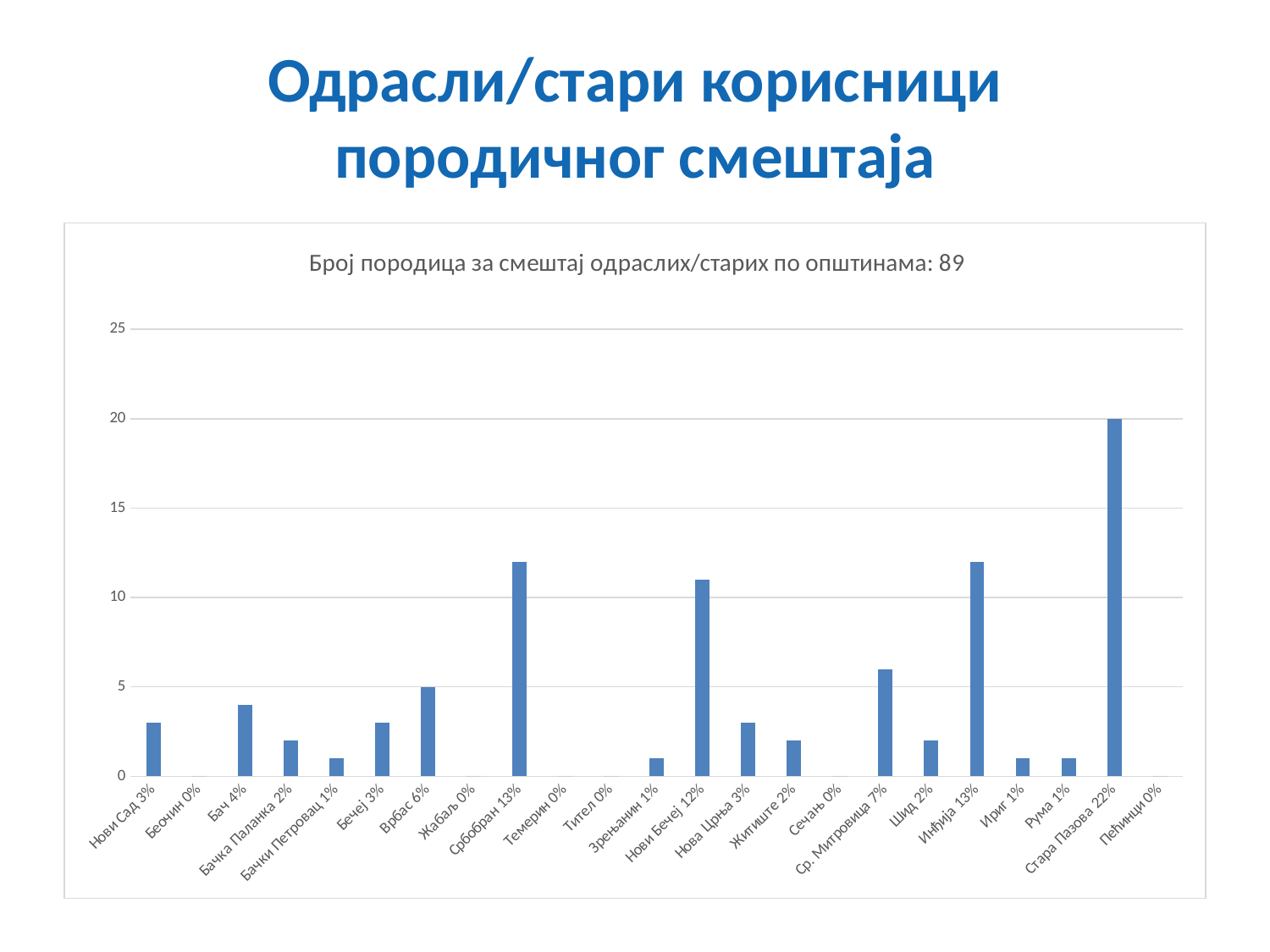
How many municipalities (categories) are shown on the x axis? 23 What percentage is shown in the label for Стара Пазова? 22% Which is larger, the bar for Нови Бечеј or the bar for Нова Црња? Нови Бечеј What is the value of the bar for Стара Пазова? 20 What is the title of the chart? Број породица за смештај одраслих/старих по општинама: 89 Is the value for Ср. Митровица greater or less than 10? less What kind of chart is shown on the slide? bar chart What percentage is shown in the label for Србобран? 13% What is the value of the bar for Беочин? 0 Is the value for Србобран greater or less than 10? greater What is the value of the bar for Врбас? 5 Which municipality has the highest bar? Стара Пазова